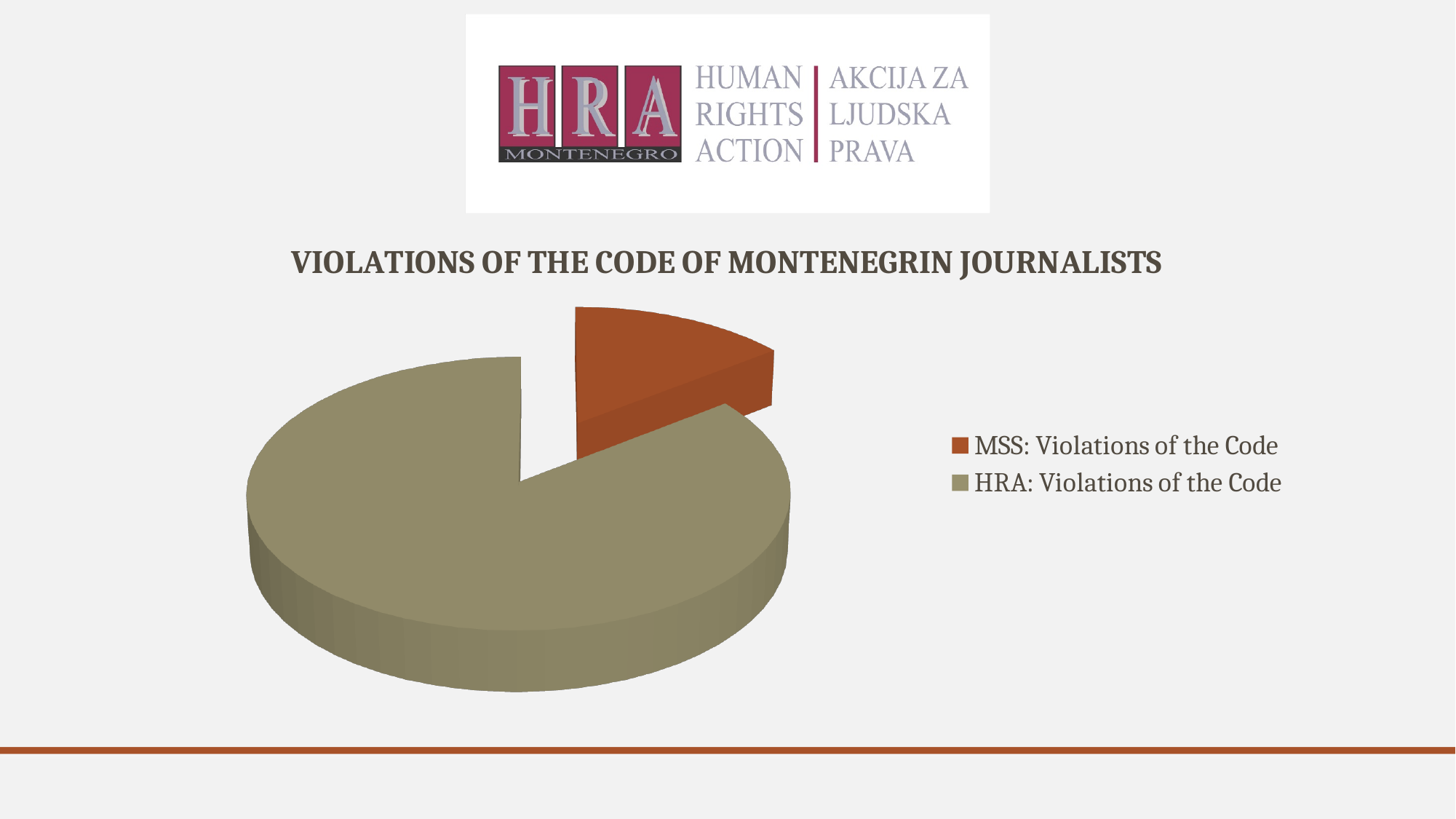
Which is larger, the slice for MSS: Violations of the Code or the slice for HRA: Violations of the Code? HRA: Violations of the Code What kind of chart is shown on the slide? pie chart Which slice is the largest in the pie chart? HRA: Violations of the Code Which slice is the smallest in the pie chart? MSS: Violations of the Code How many slices does the pie chart have? 2 How many entries does the legend list? 2 Which legend entry is shown in orange-brown? MSS: Violations of the Code What is the title of the chart? VIOLATIONS OF THE CODE OF MONTENEGRIN JOURNALISTS